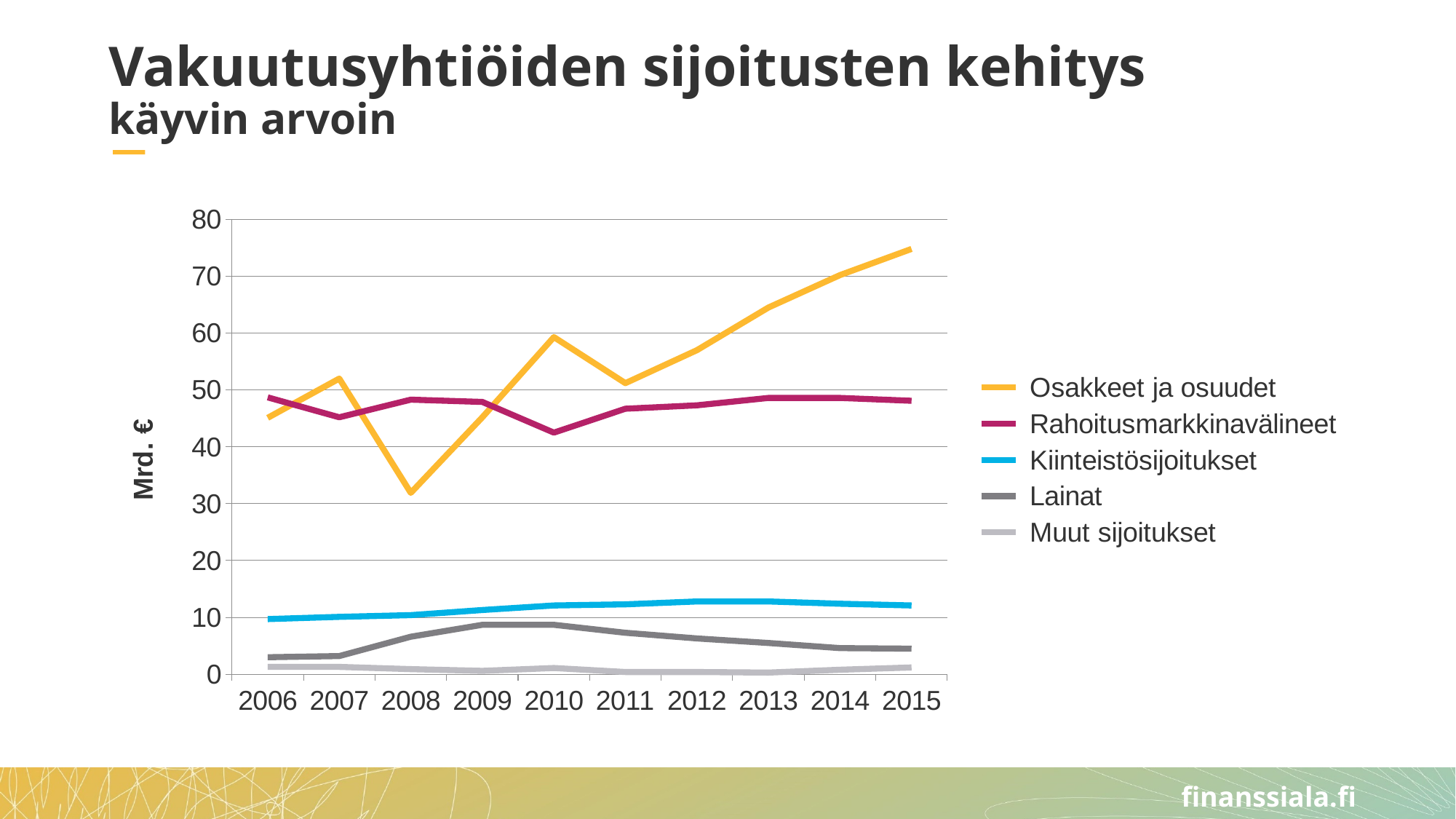
Which series has the lowest value in 2015? Muut sijoitukset Is the value for Osakkeet ja osuudet in 2015 greater or less than 70? greater What kind of chart is shown on the slide? line chart In 2010, which is larger: Osakkeet ja osuudet or Rahoitusmarkkinavälineet? Osakkeet ja osuudet Does the value for Lainat rise or fall from 2010 to 2015? fall Which series has the highest value in 2015? Osakkeet ja osuudet What is the label on the y axis? Mrd. € In which year is the value for Osakkeet ja osuudet lowest? 2008 Is the value for Kiinteistösijoitukset in 2013 greater or less than 10? greater How many series does the legend list? 5 How many years are shown on the x axis? 10 Is the value for Osakkeet ja osuudet in 2008 greater or less than 40? less